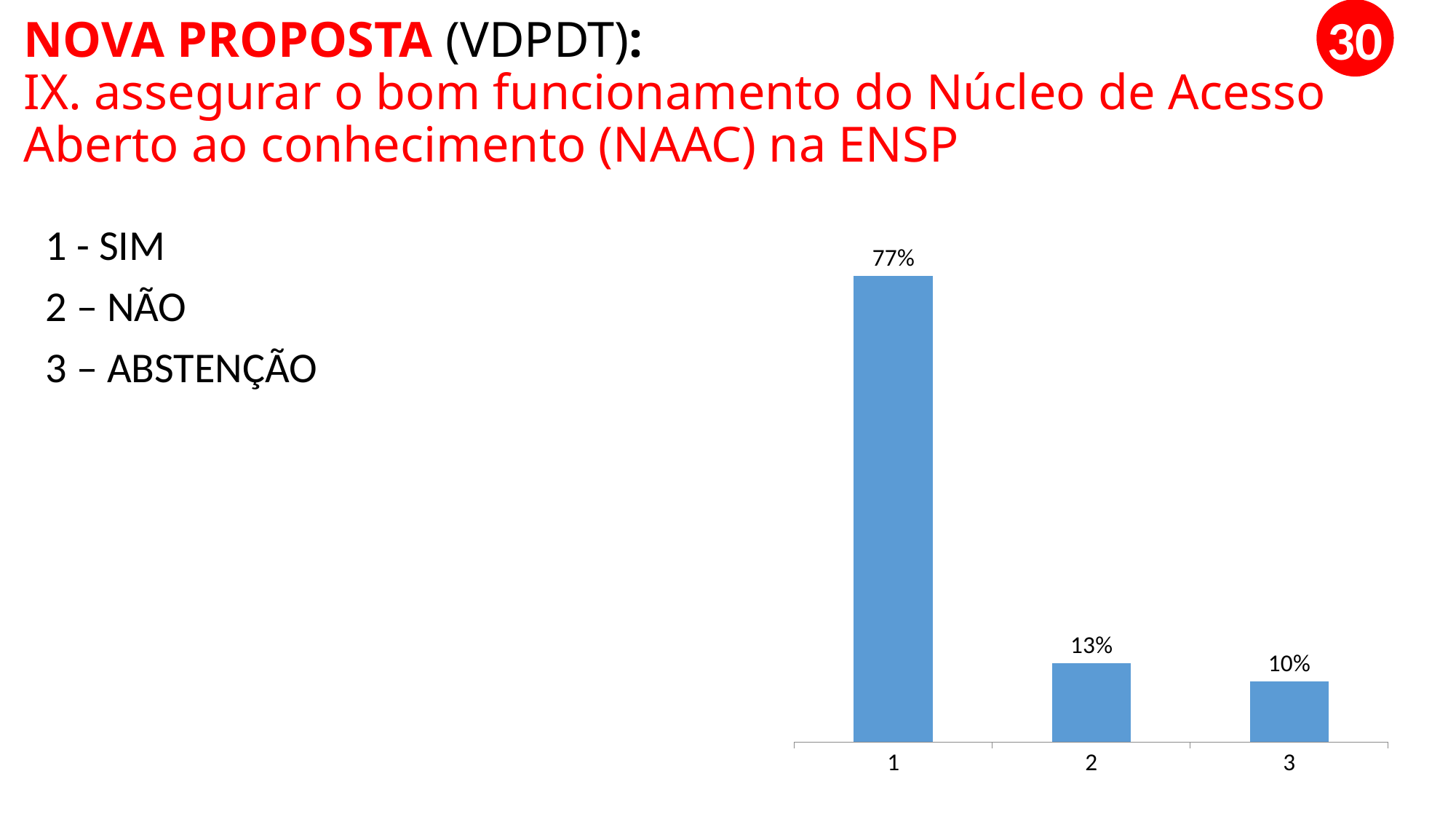
Do the values rise or fall from category 1 to category 3? fall What is the value for category 3 in the chart? 10% Which is larger, the value for category 1 or the value for category 3? 1 How many bars are shown in the chart? 3 Which category has the lowest value in the chart? 3 According to the slide's key, what does category 1 stand for? SIM What is the value for category 1 in the chart? 77% What kind of chart is shown on the slide? bar chart Which category has the highest value in the chart? 1 What is the difference between the values for category 1 and category 2? 64% What is the value for category 2 in the chart? 13% What is the difference between the values for category 2 and category 3? 3%